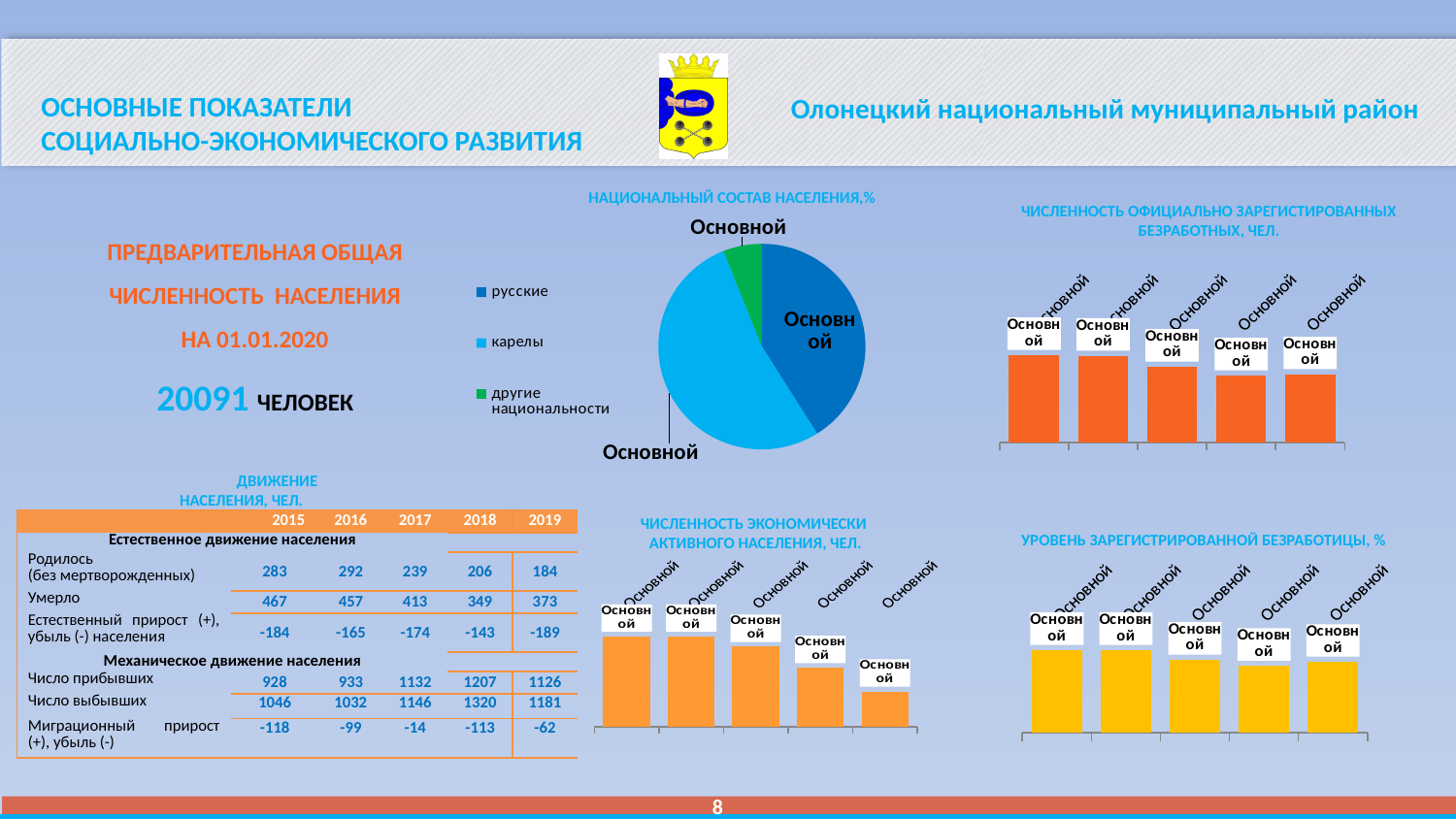
In the pie chart "НАЦИОНАЛЬНЫЙ СОСТАВ НАСЕЛЕНИЯ,%", which category has the largest slice? карелы In the chart titled "ЧИСЛЕННОСТЬ ЭКОНОМИЧЕСКИ АКТИВНОГО НАСЕЛЕНИЯ, ЧЕЛ.", do the bars rise or fall from left to right? fall What kind of chart is the chart titled "НАЦИОНАЛЬНЫЙ СОСТАВ НАСЕЛЕНИЯ,%"? pie chart In the pie chart "НАЦИОНАЛЬНЫЙ СОСТАВ НАСЕЛЕНИЯ,%", which slice is larger: карелы or другие национальности? карелы How many bars are in the chart titled "УРОВЕНЬ ЗАРЕГИСТРИРОВАННОЙ БЕЗРАБОТИЦЫ, %"? 5 How many categories does the legend of the pie chart "НАЦИОНАЛЬНЫЙ СОСТАВ НАСЕЛЕНИЯ,%" list? 3 How many bars are in the chart titled "ЧИСЛЕННОСТЬ ЭКОНОМИЧЕСКИ АКТИВНОГО НАСЕЛЕНИЯ, ЧЕЛ."? 5 What colour are the bars in the chart titled "УРОВЕНЬ ЗАРЕГИСТРИРОВАННОЙ БЕЗРАБОТИЦЫ, %"? yellow In the pie chart "НАЦИОНАЛЬНЫЙ СОСТАВ НАСЕЛЕНИЯ,%", which category has the smallest slice? другие национальности What kind of chart is the chart titled "УРОВЕНЬ ЗАРЕГИСТРИРОВАННОЙ БЕЗРАБОТИЦЫ, %"? bar chart What kind of chart is the chart titled "ЧИСЛЕННОСТЬ ОФИЦИАЛЬНО ЗАРЕГИСТРИРОВАННЫХ БЕЗРАБОТНЫХ, ЧЕЛ."? bar chart